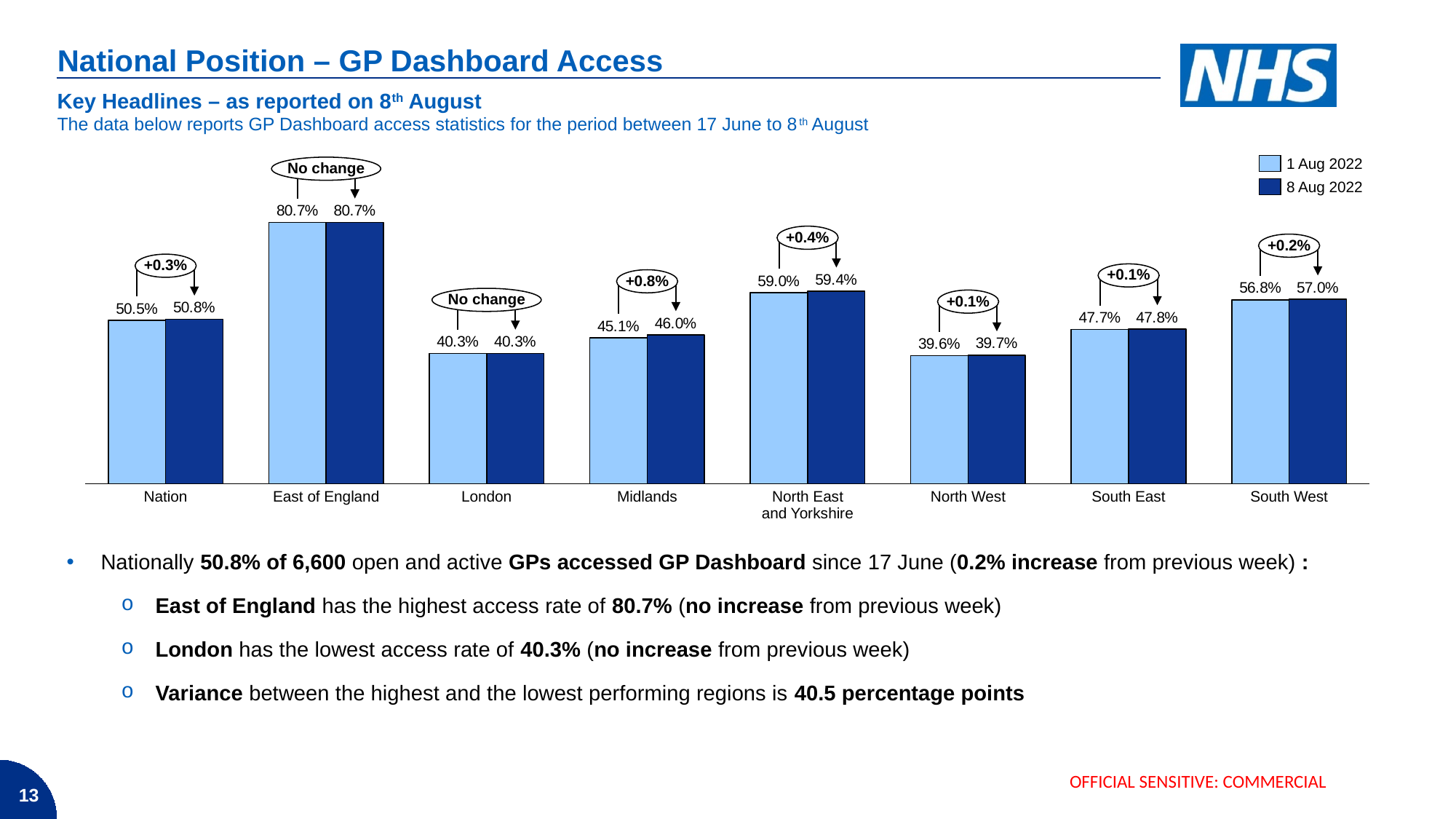
What is the value for East of England in the 8 Aug 2022 series? 80.7% What is the difference between the 8 Aug 2022 values for East of England and London? 40.5 percentage points How many series does the legend list? 2 How many categories are shown on the x axis of the chart? 8 What is the value for Midlands in the 1 Aug 2022 series? 45.1% Which is larger: the 8 Aug 2022 value for South West or the 8 Aug 2022 value for South East? South West Which category has the lowest value in the 1 Aug 2022 series? North West What is the value for North West in the 8 Aug 2022 series? 39.7% What change is annotated above the North East and Yorkshire bars? +0.4% What is the difference between the 8 Aug 2022 and 1 Aug 2022 values for Midlands? 0.8% What kind of chart is shown on the slide? Bar chart Which category has the highest value in the 8 Aug 2022 series? East of England